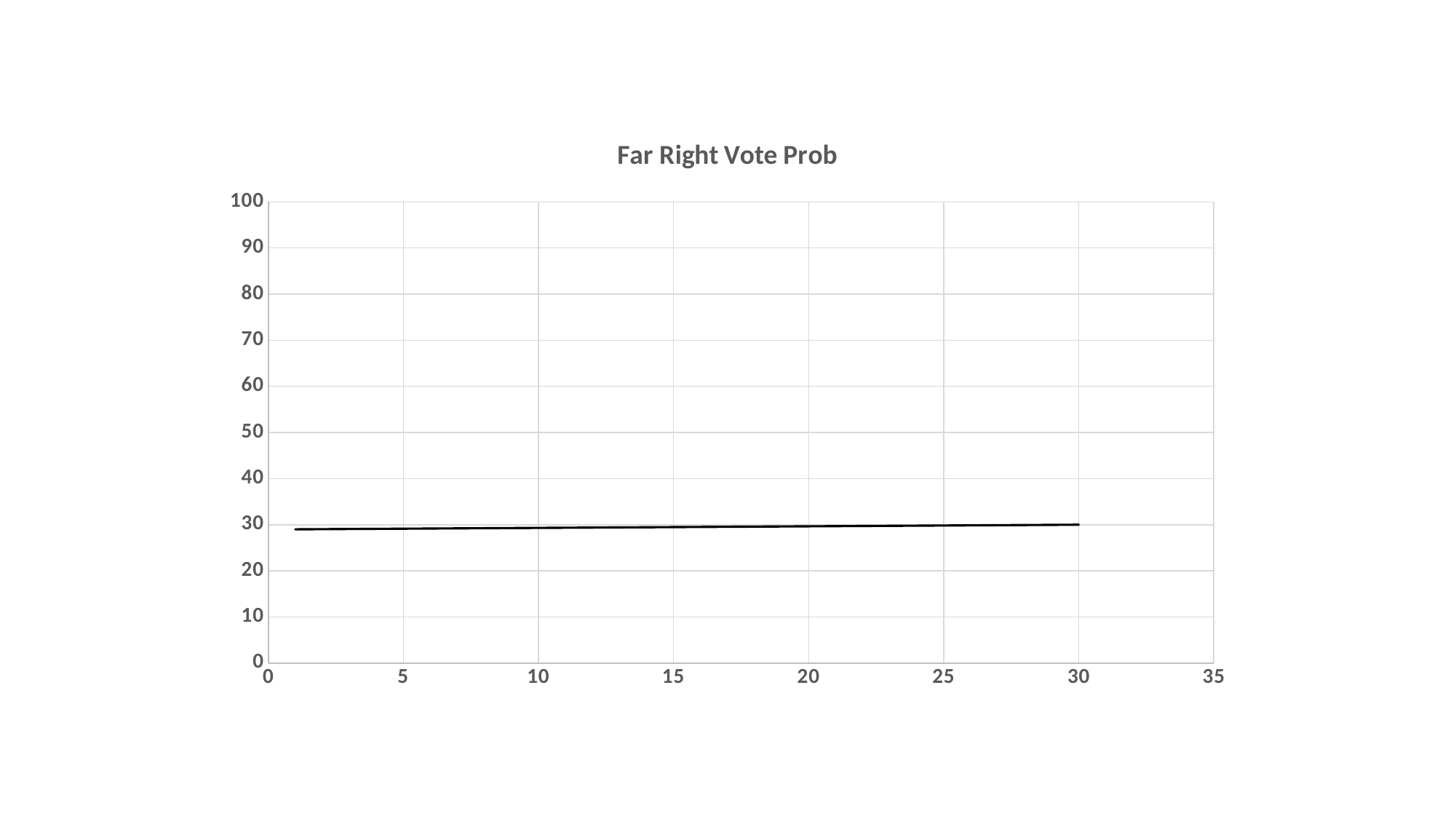
Is the value of the line at x = 30 greater or less than 50? less Is the value of the line at x = 10 greater or less than 20? greater What is the title of the chart? Far Right Vote Prob What kind of chart is shown on the slide? line chart What is the maximum value shown on the vertical axis? 100 Is the value of the line at x = 5 greater or less than 40? less Does the line stay roughly flat, rise sharply, or fall sharply across the x axis? roughly flat